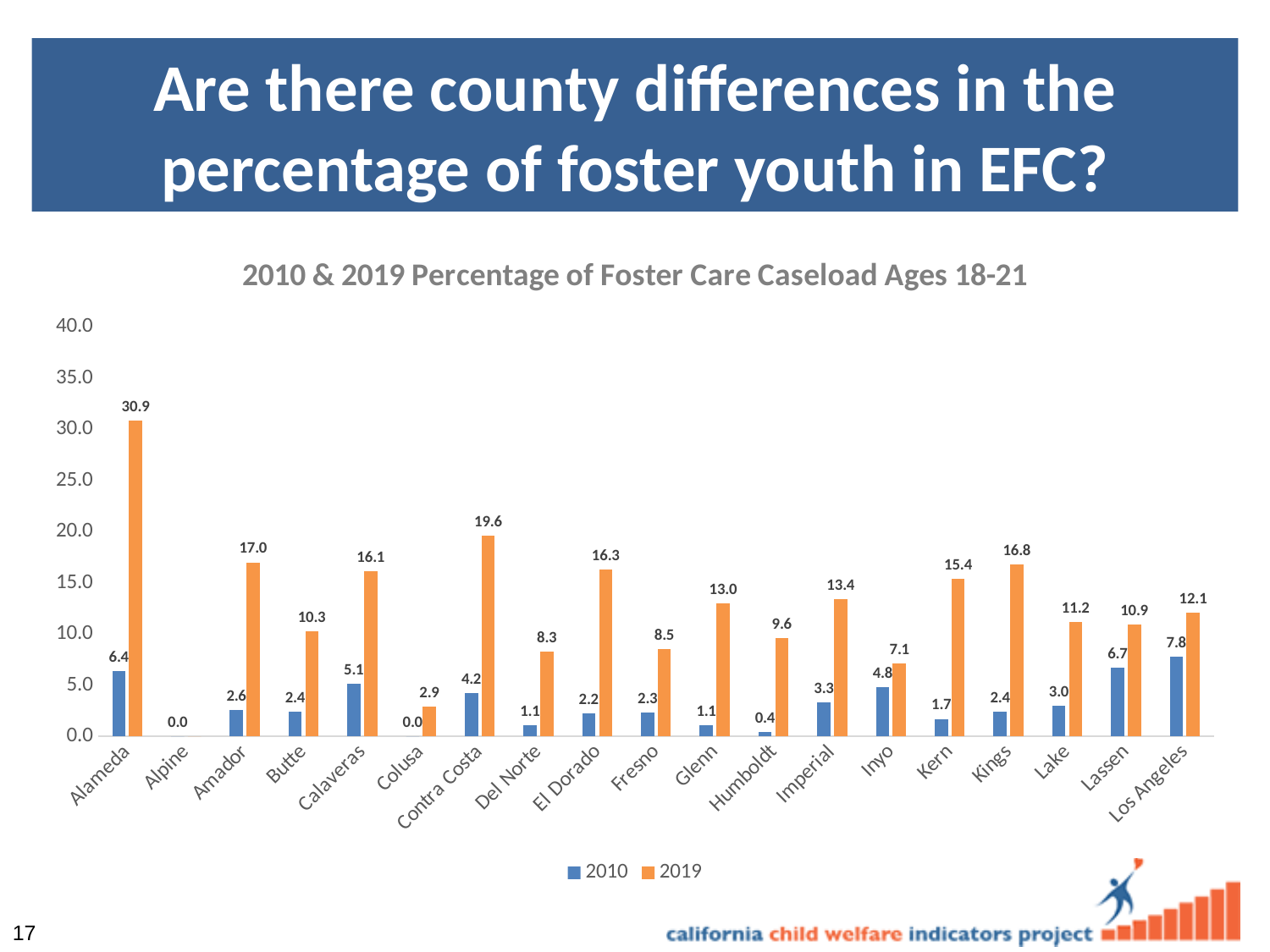
What type of chart is shown? Bar chart Which is larger, the 2019 value for Kings or the 2019 value for Calaveras? Kings What is the 2019 value for Kern? 15.4 Which county has the highest 2019 value? Alameda Which county has the highest 2010 value? Los Angeles What is the difference between the 2019 and 2010 values for Amador? 14.4 What is the 2019 value for Alameda? 30.9 How many counties are shown on the x axis? 19 Is the 2019 value for Glenn greater or less than 10.0? greater What is the difference between the 2019 values for Contra Costa and El Dorado? 3.3 What is the 2010 value for Contra Costa? 4.2 How many series does the legend list? 2